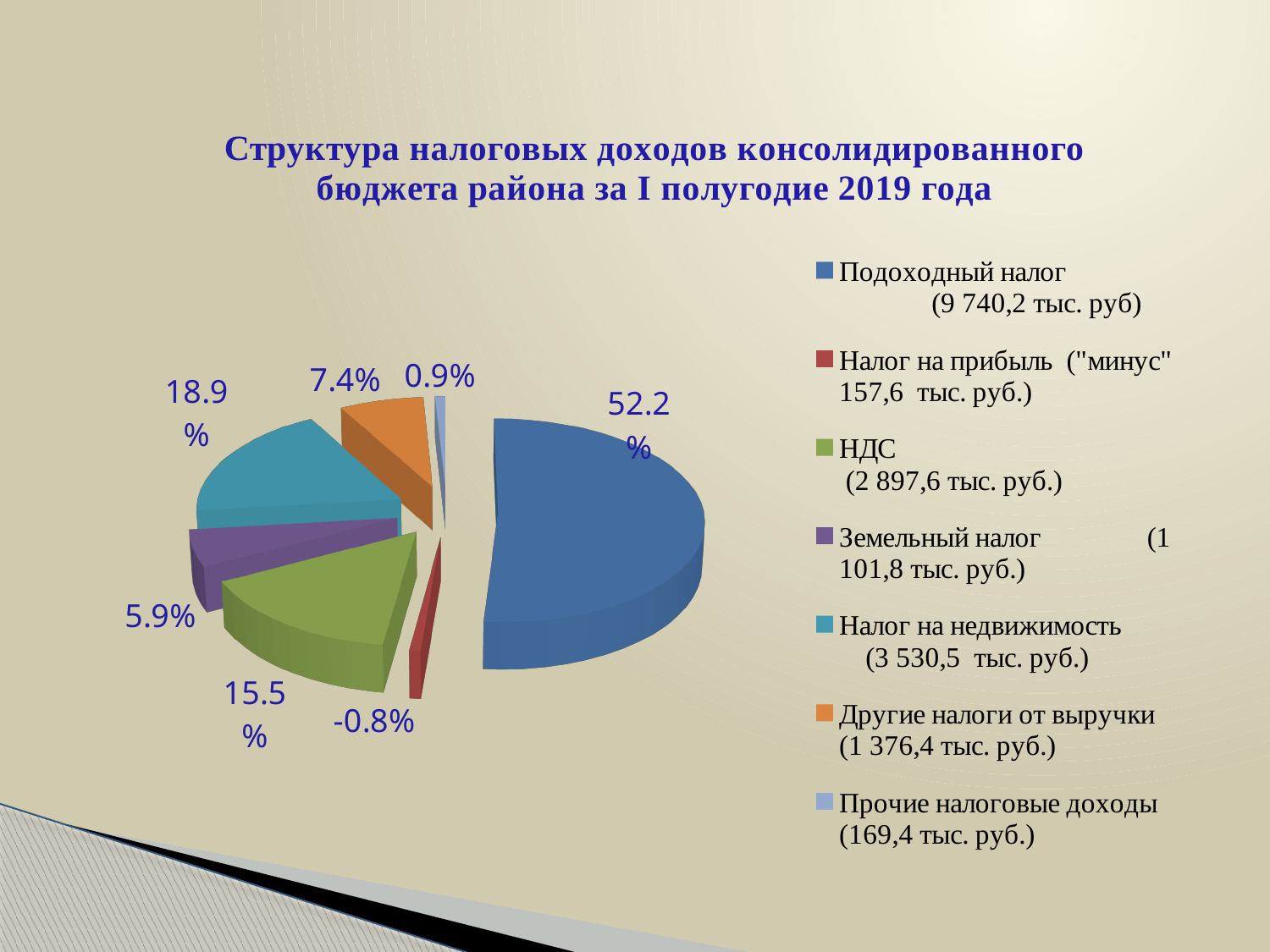
Which is larger, the share of Другие налоги от выручки or the share of Земельный налог? Другие налоги от выручки Which category has the smallest value in the chart? Налог на прибыль What amount in thousand rubles does the legend give for НДС? 2 897,6 тыс. руб. What share of the pie does Земельный налог have? 5.9% How many categories does the legend list? 7 Which category has the largest share of the pie? Подоходный налог What share of the pie does Налог на недвижимость have? 18.9% What share of the pie does Подоходный налог have? 52.2% What kind of chart is shown on the slide? Pie chart What value is shown for Налог на прибыль? -0.8% What is the difference between the shares of Налог на недвижимость and НДС? 3.4%